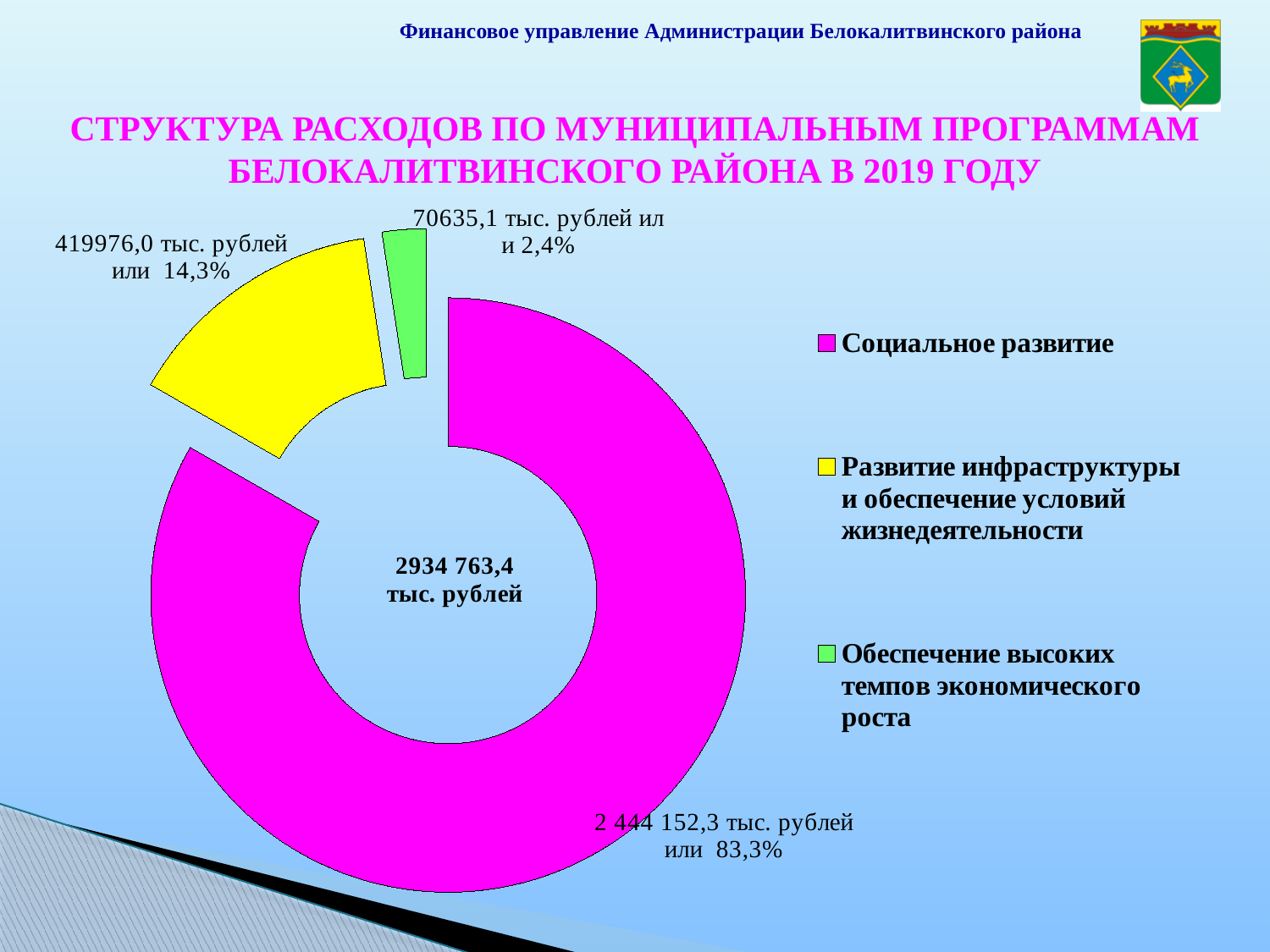
Which category has the largest share? Социальное развитие What value is shown for Социальное развитие? 2 444 152,3 тыс. рублей What colour is the slice for Обеспечение высоких темпов экономического роста? Green What share of the chart does Обеспечение высоких темпов экономического роста represent? 2,4% What is the difference in percentage points between the share of Социальное развитие and the share of Развитие инфраструктуры и обеспечение условий жизнедеятельности? 69,0 percentage points What value is shown for Развитие инфраструктуры и обеспечение условий жизнедеятельности? 419976,0 тыс. рублей What kind of chart is shown on the slide? Doughnut (pie) chart Which is larger: the value for Развитие инфраструктуры и обеспечение условий жизнедеятельности or the value for Обеспечение высоких темпов экономического роста? Развитие инфраструктуры и обеспечение условий жизнедеятельности How many categories does the chart show? 3 What share of the chart does Социальное развитие represent? 83,3% What total value is printed in the centre of the chart? 2934 763,4 тыс. рублей Which category has the smallest share? Обеспечение высоких темпов экономического роста